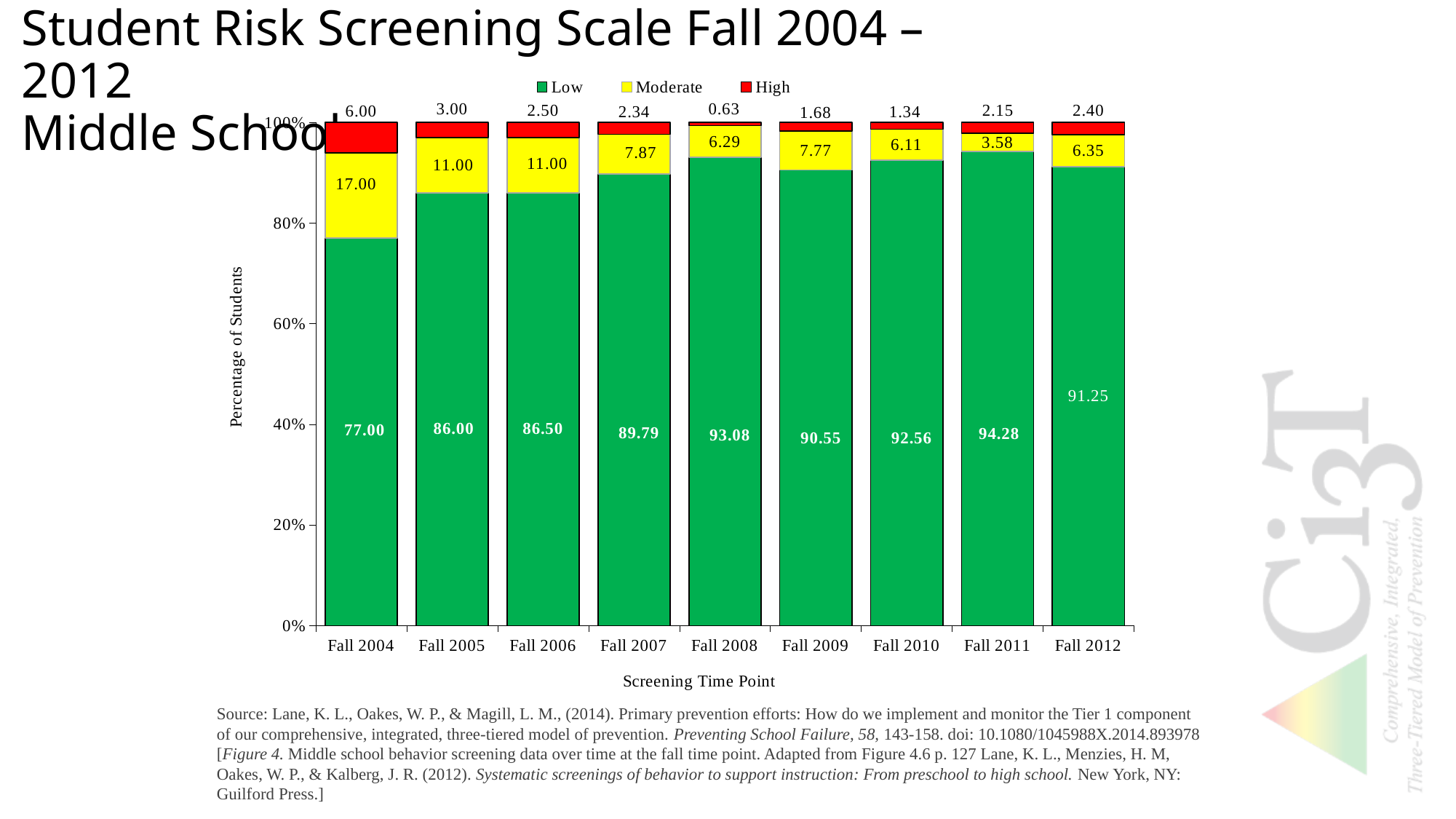
What is the total of the stacked bar for Fall 2012? 100.00 What is the Low value for Fall 2004? 77.00 How many screening time points are shown on the x axis? 9 What is the label of the y axis? Percentage of Students Which time point has the lowest High value? Fall 2008 Which time point has the highest Low value? Fall 2011 What is the High value for Fall 2008? 0.63 How many series does the legend list? 3 What is the Moderate value for Fall 2007? 7.87 What kind of chart is shown on the slide? Stacked bar chart What is the difference between the Moderate values for Fall 2004 and Fall 2005? 6.00 Which is larger, the Low value for Fall 2009 or the Low value for Fall 2010? Fall 2010